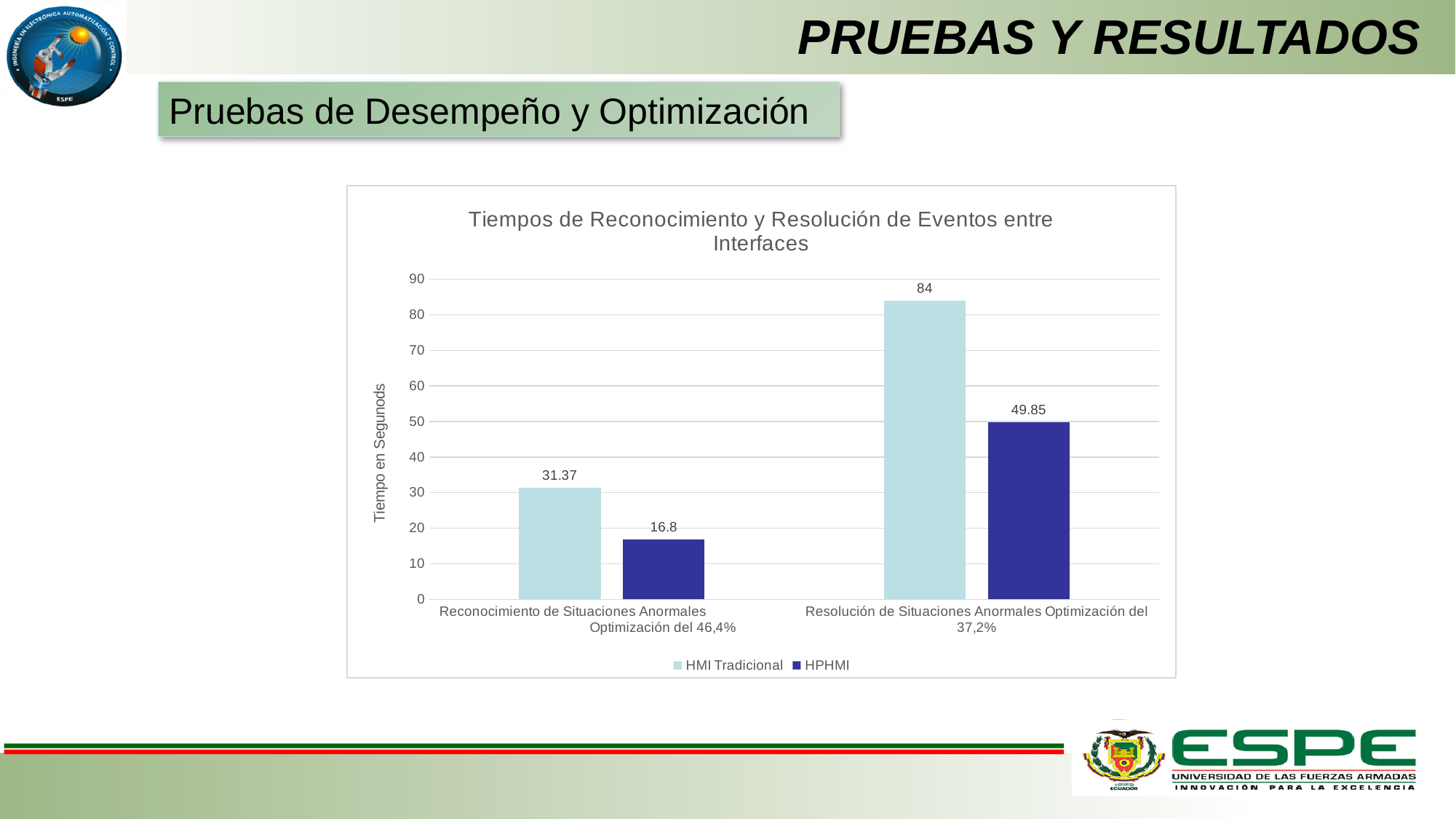
Which is larger in the Resolución de Situaciones Anormales category, HMI Tradicional or HPHMI? HMI Tradicional What is the value for HPHMI in the Reconocimiento de Situaciones Anormales category? 16.8 What is the value for HPHMI in the Resolución de Situaciones Anormales category? 49.85 What is the value for HMI Tradicional in the Reconocimiento de Situaciones Anormales category? 31.37 How many series does the legend list? 2 What is the difference between HMI Tradicional and HPHMI in the Resolución de Situaciones Anormales category? 34.15 What is the difference between HMI Tradicional and HPHMI in the Reconocimiento de Situaciones Anormales category? 14.57 What is the label of the vertical axis? Tiempo en Segunods Which bar has the lowest value on the chart? HPHMI, Reconocimiento de Situaciones Anormales What kind of chart is shown on the slide? Bar chart Which bar has the highest value on the chart? HMI Tradicional, Resolución de Situaciones Anormales What is the value for HMI Tradicional in the Resolución de Situaciones Anormales category? 84